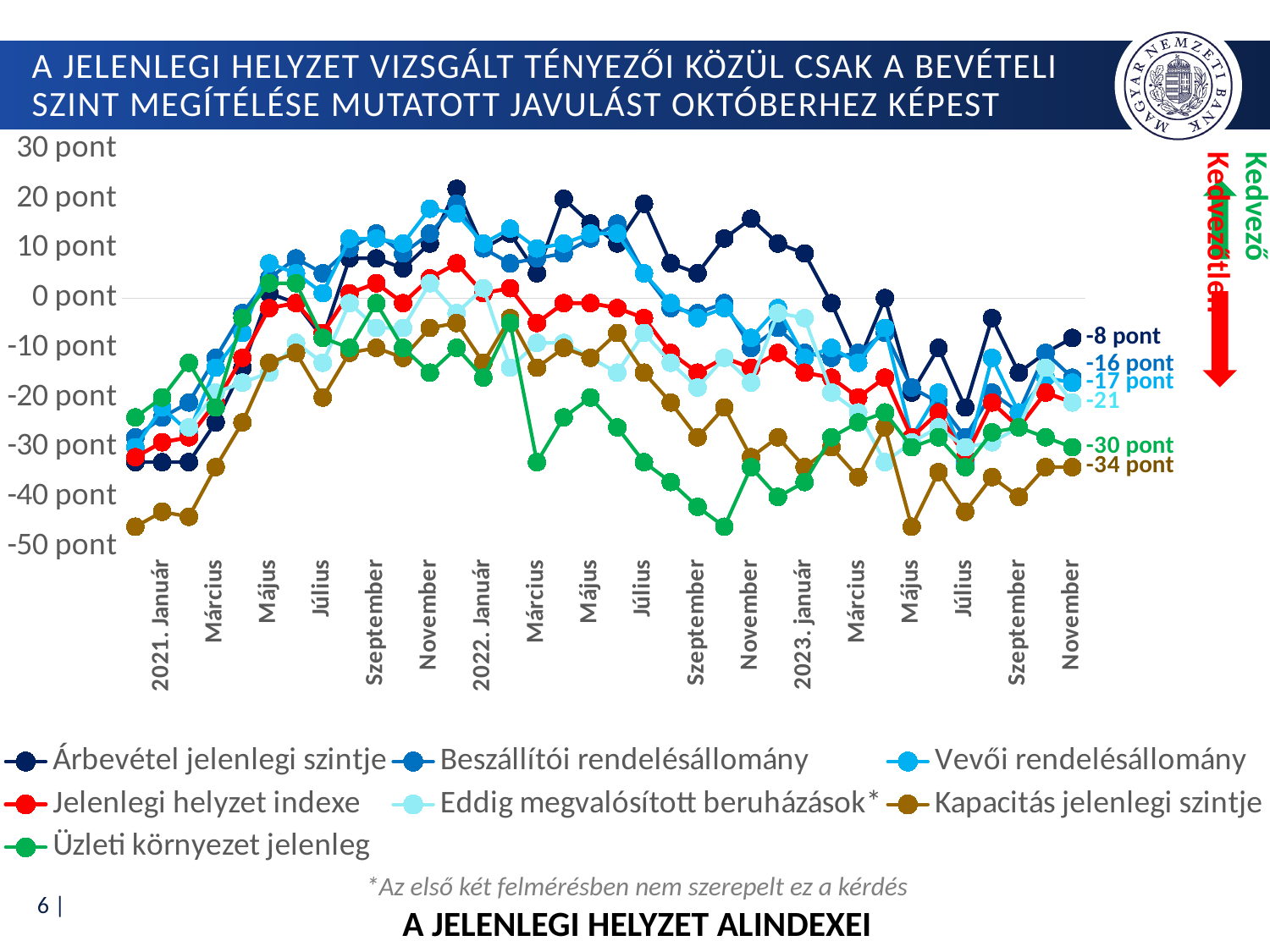
Which series has the lowest value at the last point (November 2023)? Kapacitás jelenlegi szintje What is the value of Üzleti környezet jelenleg at the last point (November 2023)? -30 pont What is the value of Árbevétel jelenlegi szintje at the last point (November 2023)? -8 pont What is the value of Vevői rendelésállomány at the last point (November 2023)? -17 pont What is the value of Beszállítói rendelésállomány at the last point (November 2023)? -16 pont Is the value of Kapacitás jelenlegi szintje in 2021. Január greater or less than -40 pont? less How many series does the legend list? 7 Which series is marked with an asterisk in the legend? Eddig megvalósított beruházások What is the value of Kapacitás jelenlegi szintje at the last point (November 2023)? -34 pont What is the difference between the final values of Árbevétel jelenlegi szintje (-8 pont) and Kapacitás jelenlegi szintje (-34 pont)? 26 pont What type of chart is shown on the slide? line chart Which series has the highest value at the last point (November 2023)? Árbevétel jelenlegi szintje